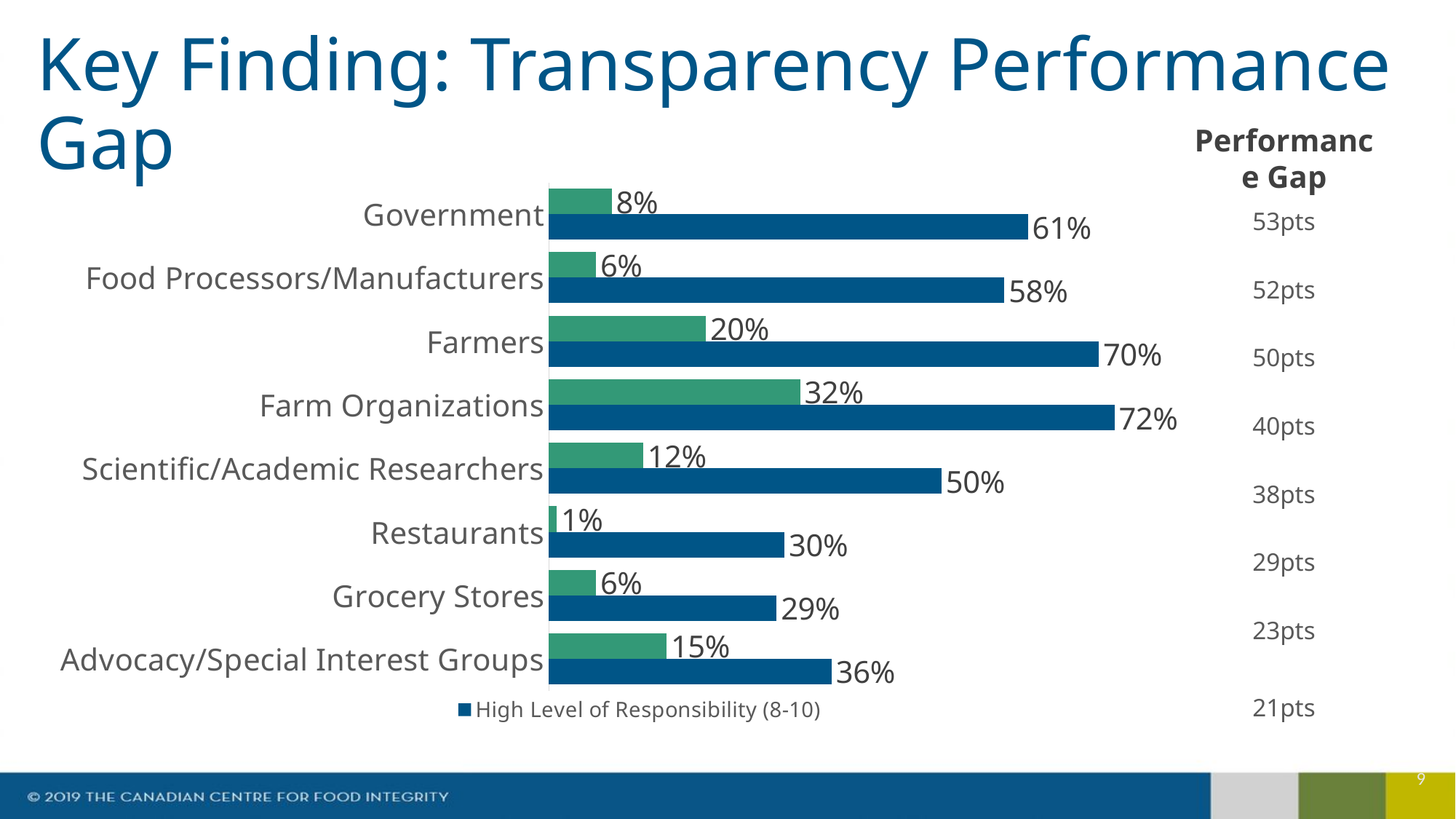
Which category has the highest High Level of Responsibility (8-10) value? Farm Organizations What is the difference between the High Level of Responsibility (8-10) values for Farmers and Scientific/Academic Researchers? 20pts What is the High Level of Responsibility (8-10) value for Farmers? 70% What is the difference between the High Level of Responsibility (8-10) value and the green bar value for Government? 53pts What is the High Level of Responsibility (8-10) value for Restaurants? 30% Which category has the lowest value for the green bar? Restaurants What is the Performance Gap listed for Food Processors/Manufacturers? 52pts What is the value of the green bar for Farm Organizations? 32% Which is larger: the High Level of Responsibility (8-10) value for Grocery Stores or for Advocacy/Special Interest Groups? Advocacy/Special Interest Groups What series name is shown in the chart legend? High Level of Responsibility (8-10) What kind of chart is shown on the slide? bar chart How many categories are shown on the chart? 8